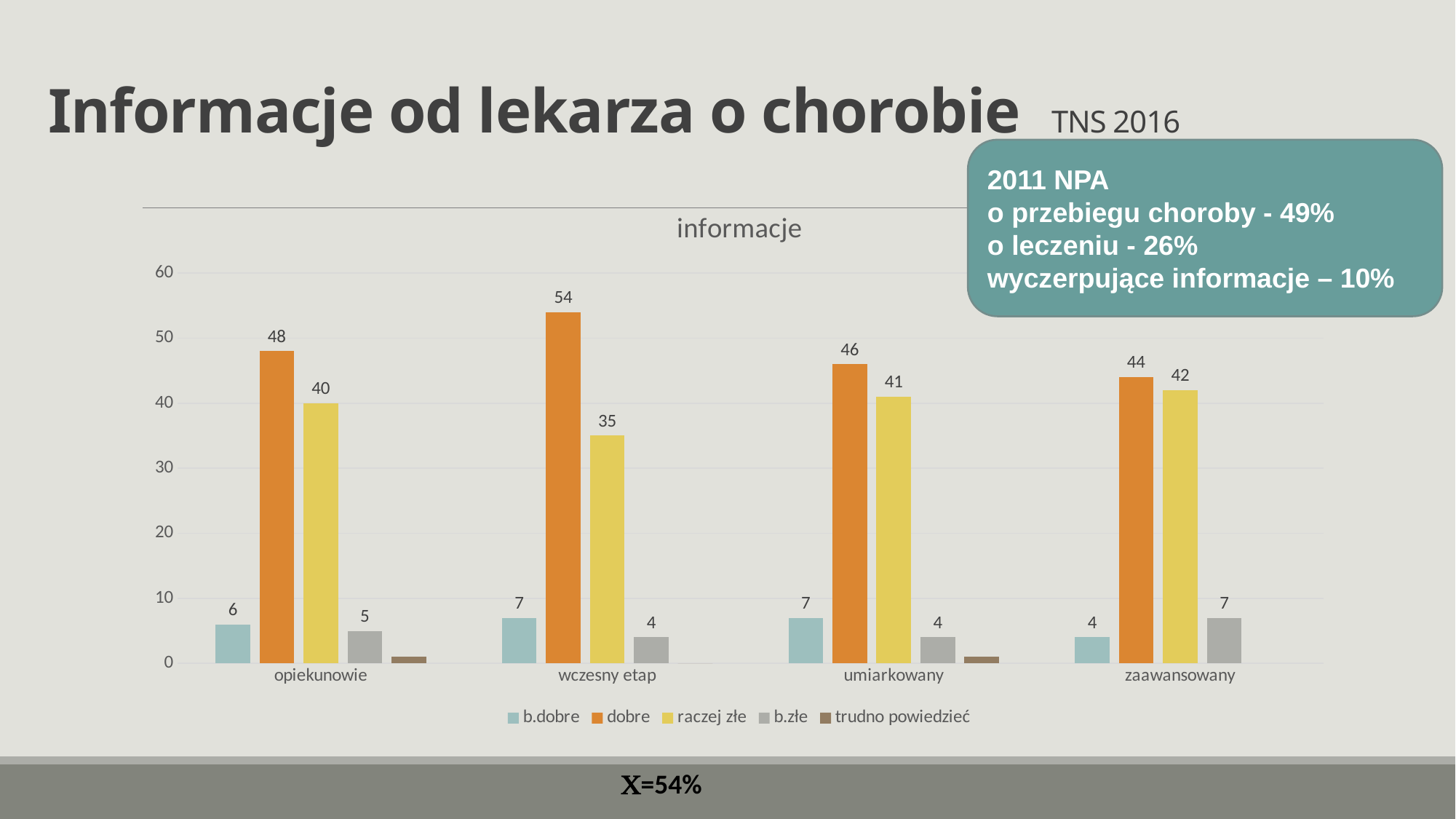
What type of chart is shown on the slide? bar chart What is the value of "raczej złe" for "opiekunowie"? 40 How many categories are shown on the x axis? 4 Which is larger for "umiarkowany": "dobre" or "raczej złe"? dobre Which category has the highest value for "dobre"? wczesny etap What is the difference between "dobre" and "raczej złe" for "wczesny etap"? 19 What is the value of "dobre" for "wczesny etap"? 54 How many series does the legend list? 5 What is the value of "b.złe" for "zaawansowany"? 7 Is the value of "trudno powiedzieć" for "opiekunowie" greater or less than 10? less What is the value of "b.dobre" for "umiarkowany"? 7 Which category has the lowest value for "b.dobre"? zaawansowany